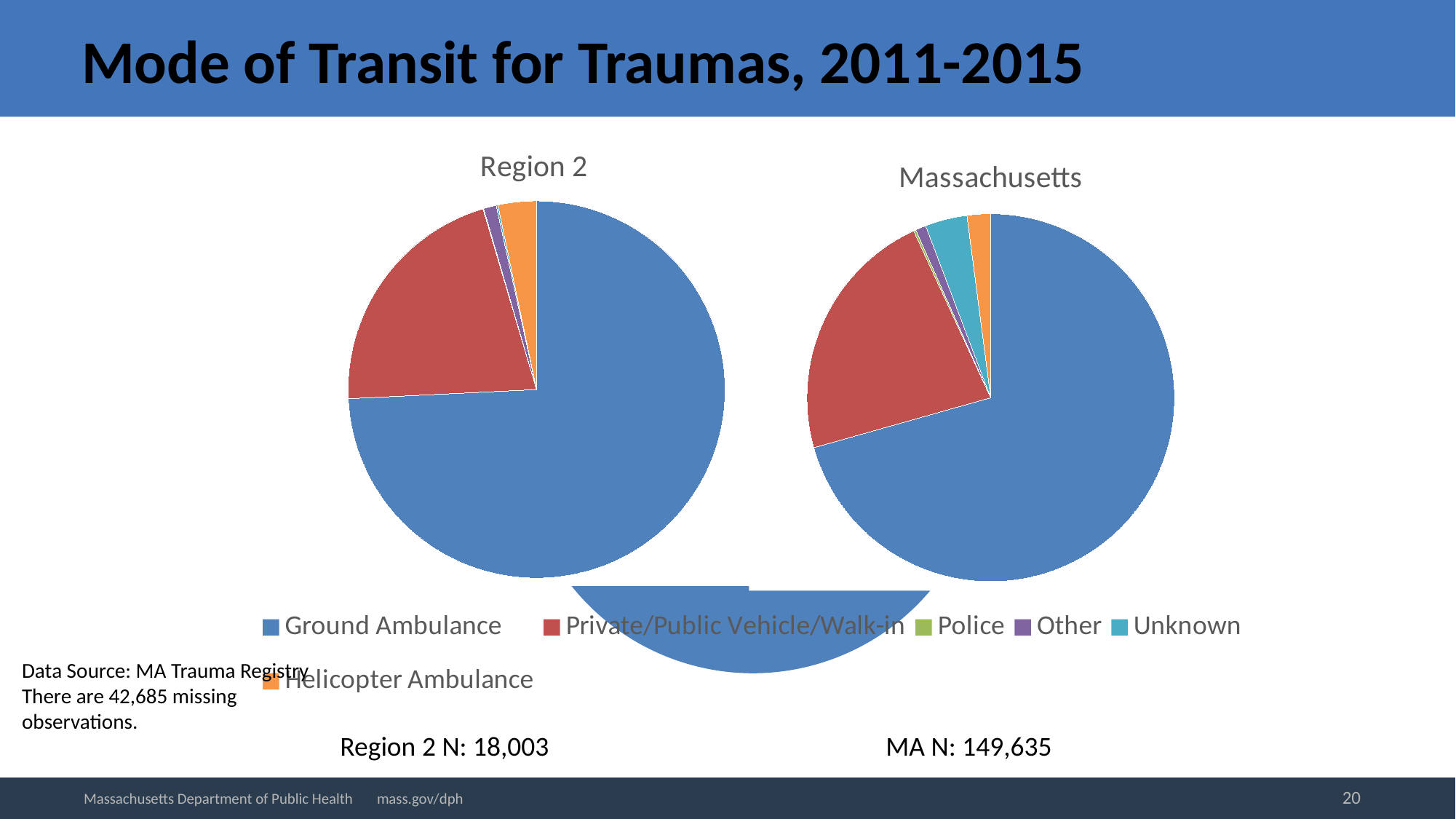
What colour represents Ground Ambulance in the pie charts? Blue What is the title of the slide containing the two pie charts? Mode of Transit for Traumas, 2011-2015 In the Region 2 pie chart, which is larger: the Ground Ambulance slice or the Private/Public Vehicle/Walk-in slice? Ground Ambulance Which chart shows a visibly larger Unknown share: Region 2 or Massachusetts? Massachusetts How many categories does the legend list for the pie charts? 6 In the Region 2 pie chart, which mode of transit has the largest slice? Ground Ambulance In the Massachusetts pie chart, which is larger: the Private/Public Vehicle/Walk-in slice or the Helicopter Ambulance slice? Private/Public Vehicle/Walk-in What kind of chart is the Region 2 chart? Pie chart What kind of chart is the Massachusetts chart? Pie chart In the Massachusetts pie chart, which mode of transit has the largest slice? Ground Ambulance